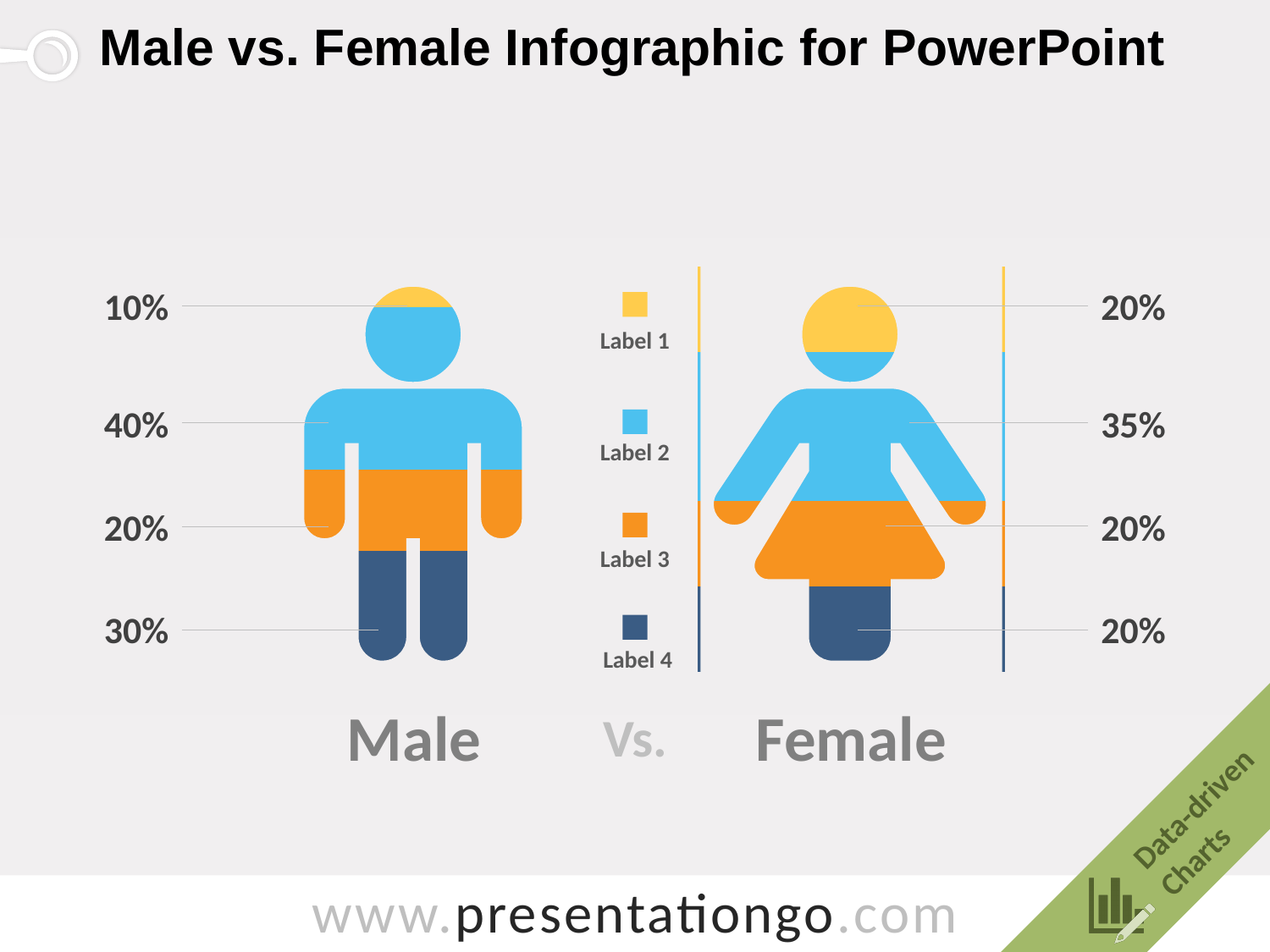
In the Male chart, which label has the highest value? Label 2 How many labels does the legend list? 4 In the Female chart, what is the value for Label 1? 20% What is the total of the four Male values? 100% What colour represents Label 3 in the legend? Orange In the Male chart, what is the value for Label 2? 40% What is the difference between the Male and Female values for Label 1? 10% In the Female chart, what is the value for Label 2? 35% In the Female chart, which label has the highest value? Label 2 In the Male chart, which label has the lowest value? Label 1 In the Male chart, what is the value for Label 4? 30% Which is larger, the Male value for Label 4 or the Female value for Label 4? Male